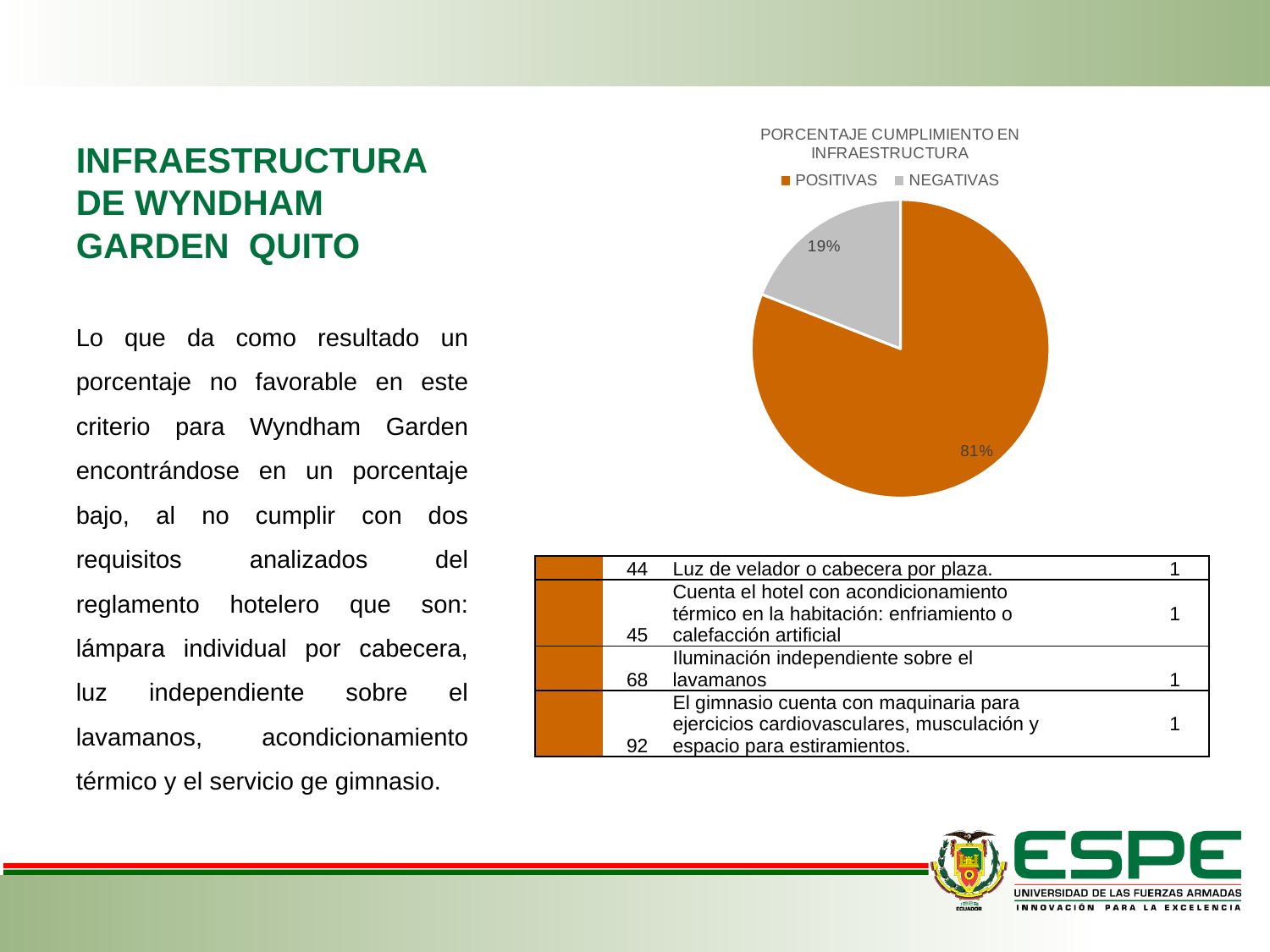
Which slice is the smallest in the pie chart? NEGATIVAS What colour is the POSITIVAS slice? orange Which is larger, the POSITIVAS slice or the NEGATIVAS slice? POSITIVAS What percentage does the POSITIVAS slice show? 81% Which slice is the largest in the pie chart? POSITIVAS How many entries does the legend list? 2 What kind of chart is shown on the slide? pie chart Is the value for NEGATIVAS greater or less than 50%? less What percentage does the NEGATIVAS slice show? 19% What is the title of the pie chart? PORCENTAJE CUMPLIMIENTO EN INFRAESTRUCTURA How many slices does the pie chart have? 2 What is the difference in percentage points between the POSITIVAS and NEGATIVAS slices? 62